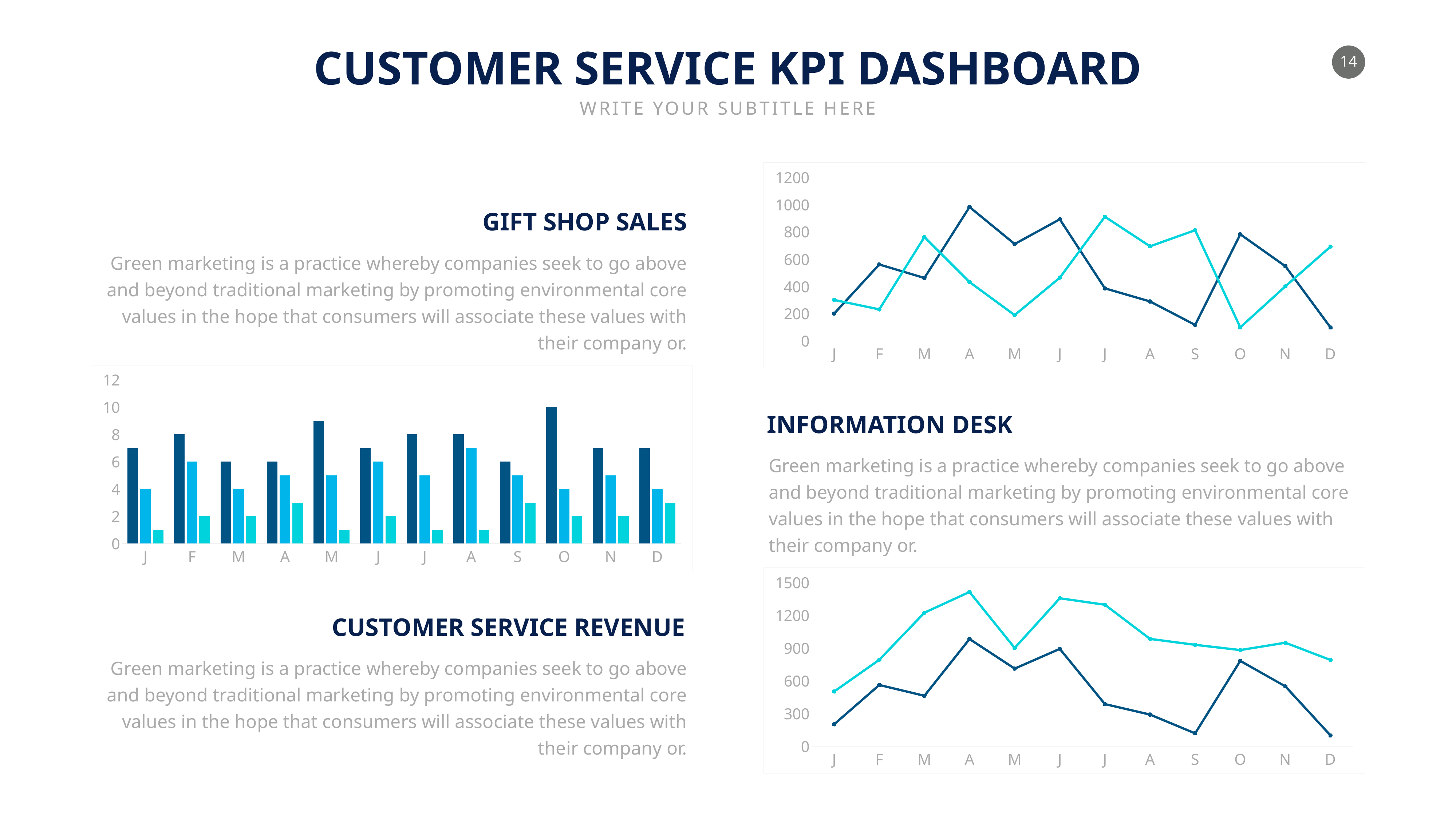
How many months are shown on the x axis of the bar chart on the left? 12 In the bar chart on the left, which month has the tallest dark blue bar? O In the bar chart on the left, what is the value of the dark blue bar for F? 8 What kind of chart is the chart on the left side of the slide? bar chart In the bottom-right line chart, is the value of the light blue line at A (April) greater or less than 1200? greater In the top-right line chart, in which month does the dark blue line reach its highest point? A (April) In the bar chart on the left, what is the value of the dark blue bar for O? 10 In the bottom-right line chart, which month has the lowest value on the light blue line? J (January) In the top-right line chart, is the value of the light blue line at J (July) greater or less than 800? greater In the bar chart on the left, is the dark blue bar for O greater or less than 8? greater What kind of chart is the chart in the top right of the slide? line chart